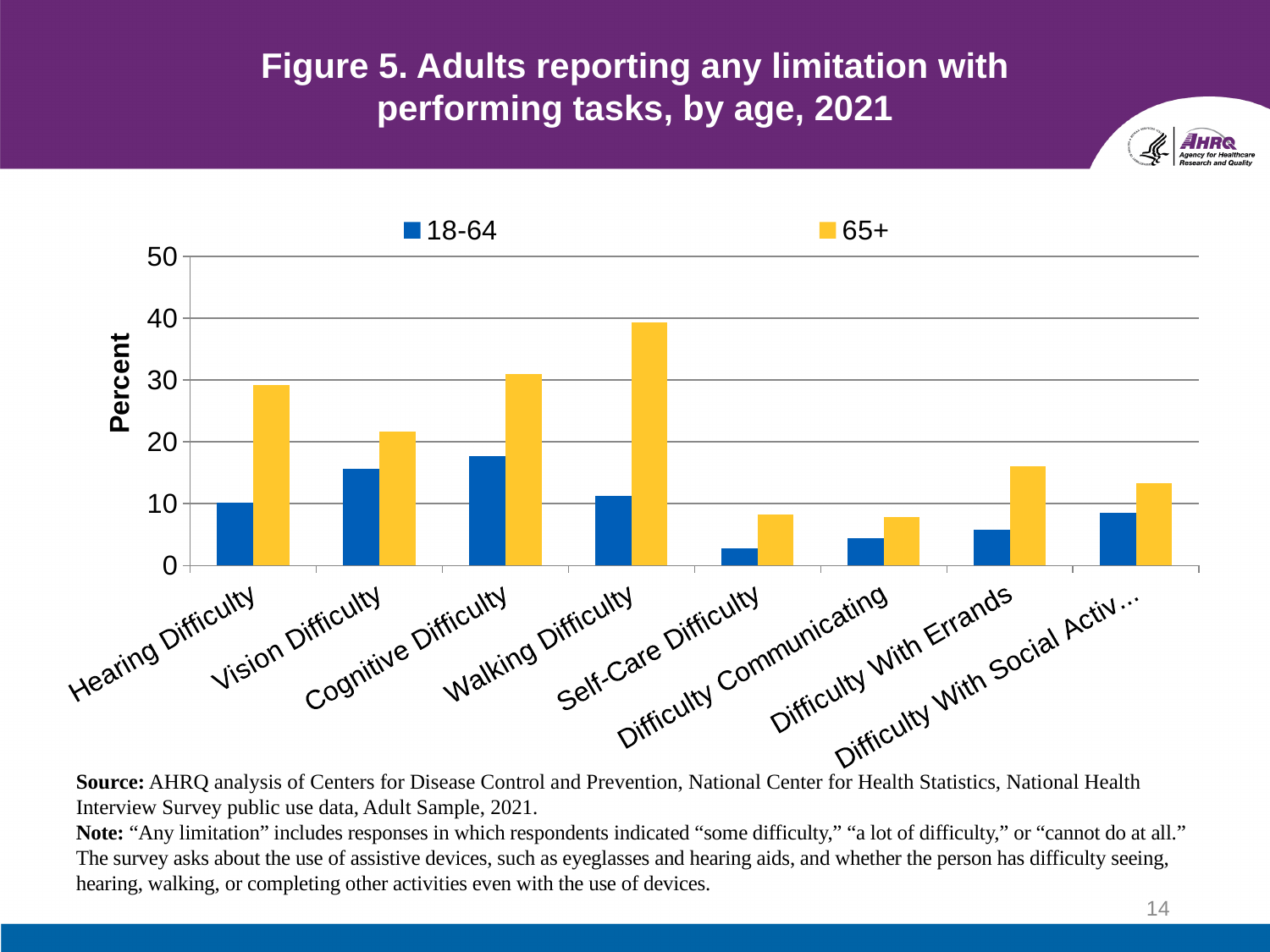
How many task categories are shown on the x axis? 8 Which category has the lowest value for the 18-64 series? Self-Care Difficulty For the 65+ series, which is larger: Hearing Difficulty or Vision Difficulty? Hearing Difficulty How many series does the legend list? 2 Which category has the highest value for the 18-64 series? Cognitive Difficulty Is the 65+ value for Difficulty With Errands greater or less than 10? greater Is the 18-64 value for Self-Care Difficulty greater or less than 10? less What label is shown on the y axis? Percent Is the 65+ value for Hearing Difficulty greater or less than 20? greater Which category has the highest value for the 65+ series? Walking Difficulty What type of chart is shown on the slide? Bar chart